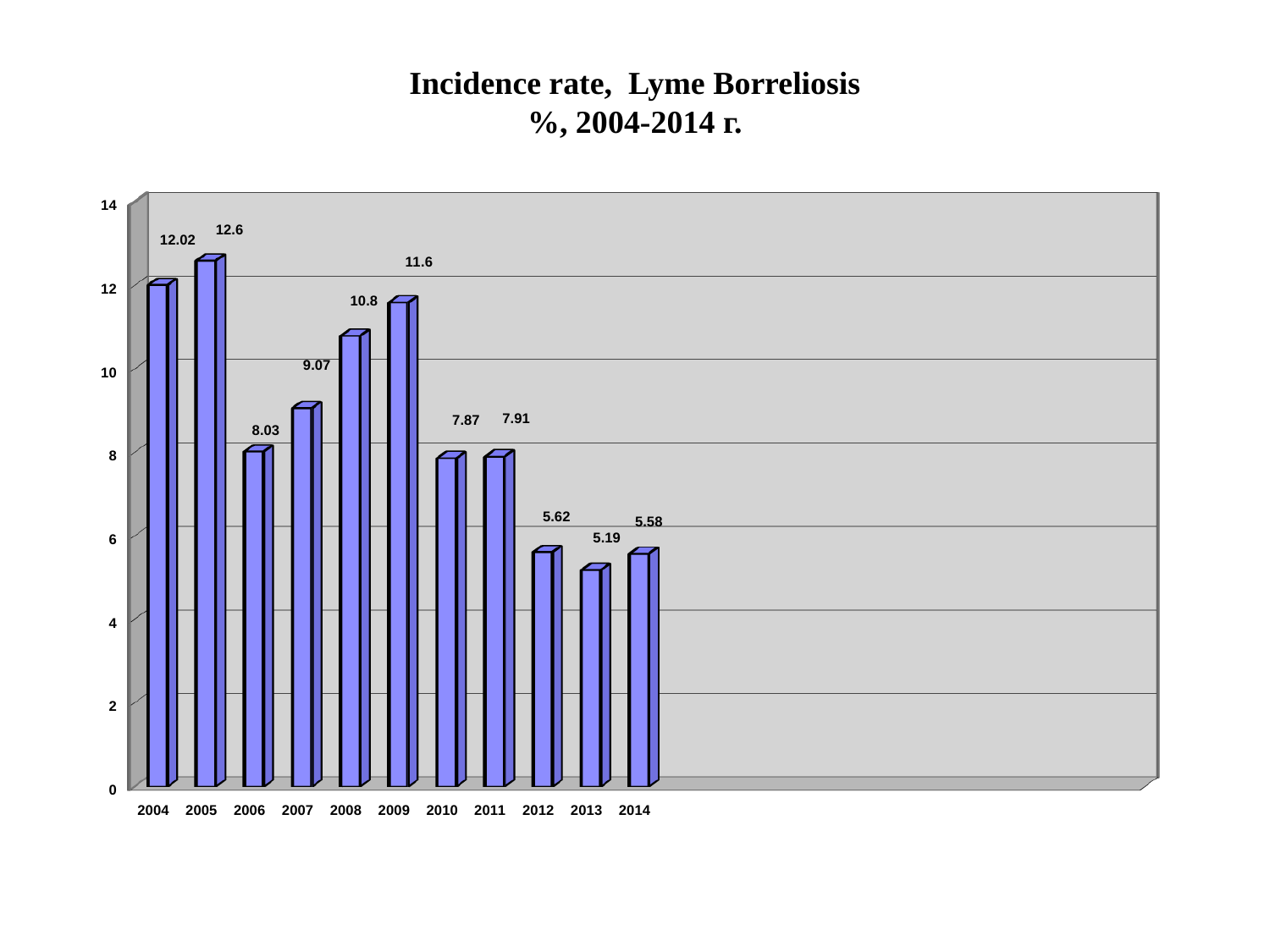
What is the incidence rate for 2004? 12.02 Is the value for 2012 greater or less than 6? less Do the values generally rise or fall from 2009 to 2013? fall How many years are shown on the x axis? 11 What is the title of the chart? Incidence rate, Lyme Borreliosis %, 2004-2014 г. What is the difference between the incidence rates for 2005 and 2014? 7.02 Which year has the highest incidence rate? 2005 What is the incidence rate for 2013? 5.19 Which year has the lowest incidence rate? 2013 What is the incidence rate for 2009? 11.6 Which year has a higher incidence rate, 2008 or 2009? 2009 What kind of chart is shown on the slide? bar chart